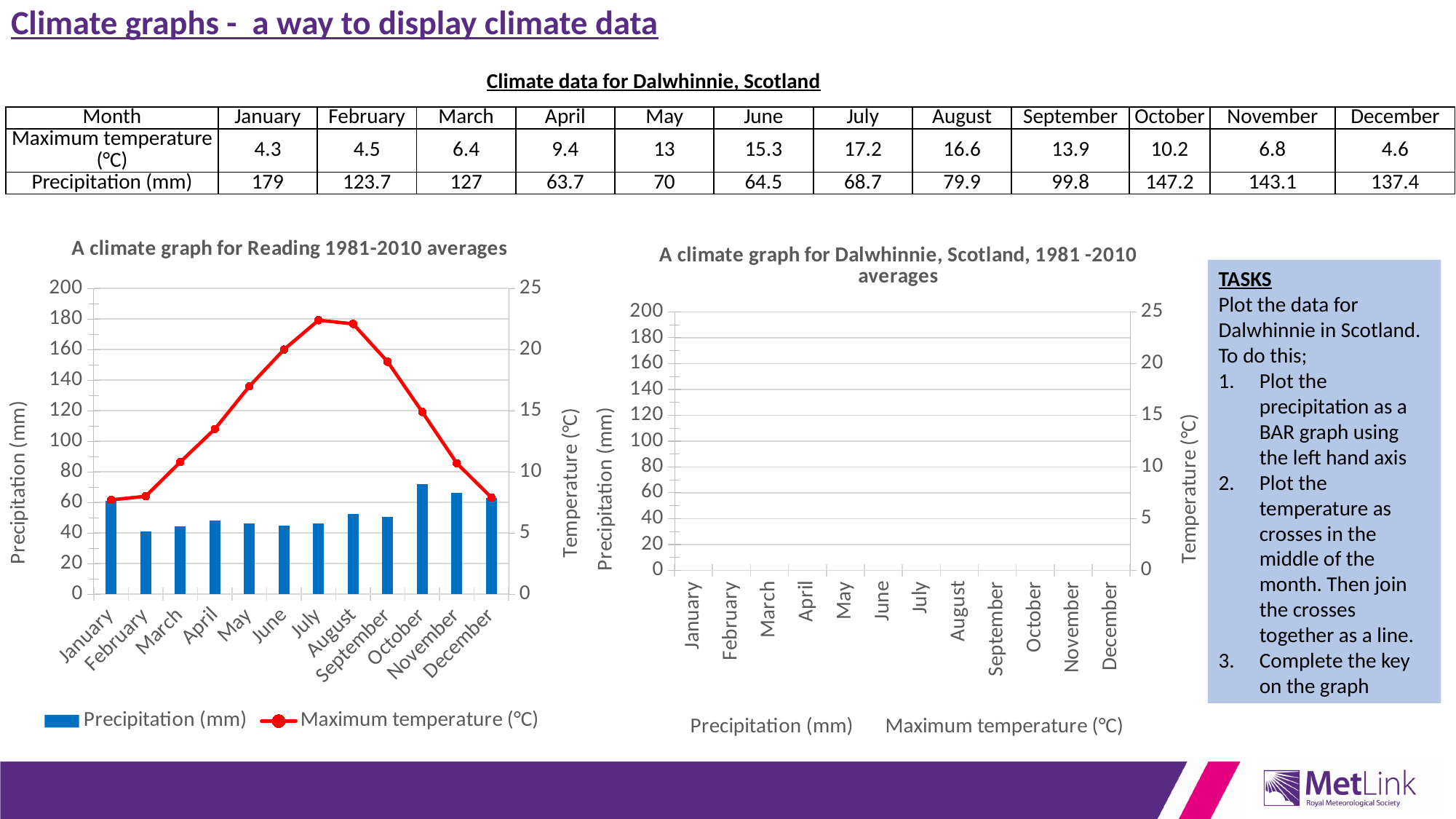
On the chart titled 'A climate graph for Reading 1981-2010 averages', which has the larger precipitation, October or February? October On the chart titled 'A climate graph for Reading 1981-2010 averages', how does the maximum temperature change from January to July? It rises On the chart titled 'A climate graph for Reading 1981-2010 averages', how many series does the legend list? 2 On the chart titled 'A climate graph for Reading 1981-2010 averages', how many months are shown on the x axis? 12 On the chart titled 'A climate graph for Reading 1981-2010 averages', is the maximum temperature for January greater or less than 10 °C? less On the chart titled 'A climate graph for Reading 1981-2010 averages', is the precipitation for October greater or less than 60 mm? greater On the chart titled 'A climate graph for Reading 1981-2010 averages', is the maximum temperature for July greater or less than 20 °C? greater On the chart titled 'A climate graph for Reading 1981-2010 averages', what kind of chart is used for precipitation? Bar chart On the chart titled 'A climate graph for Reading 1981-2010 averages', which month has the lowest precipitation bar? February On the chart titled 'A climate graph for Reading 1981-2010 averages', which month has the highest maximum temperature? July On the chart titled 'A climate graph for Reading 1981-2010 averages', which month has the highest precipitation bar? October